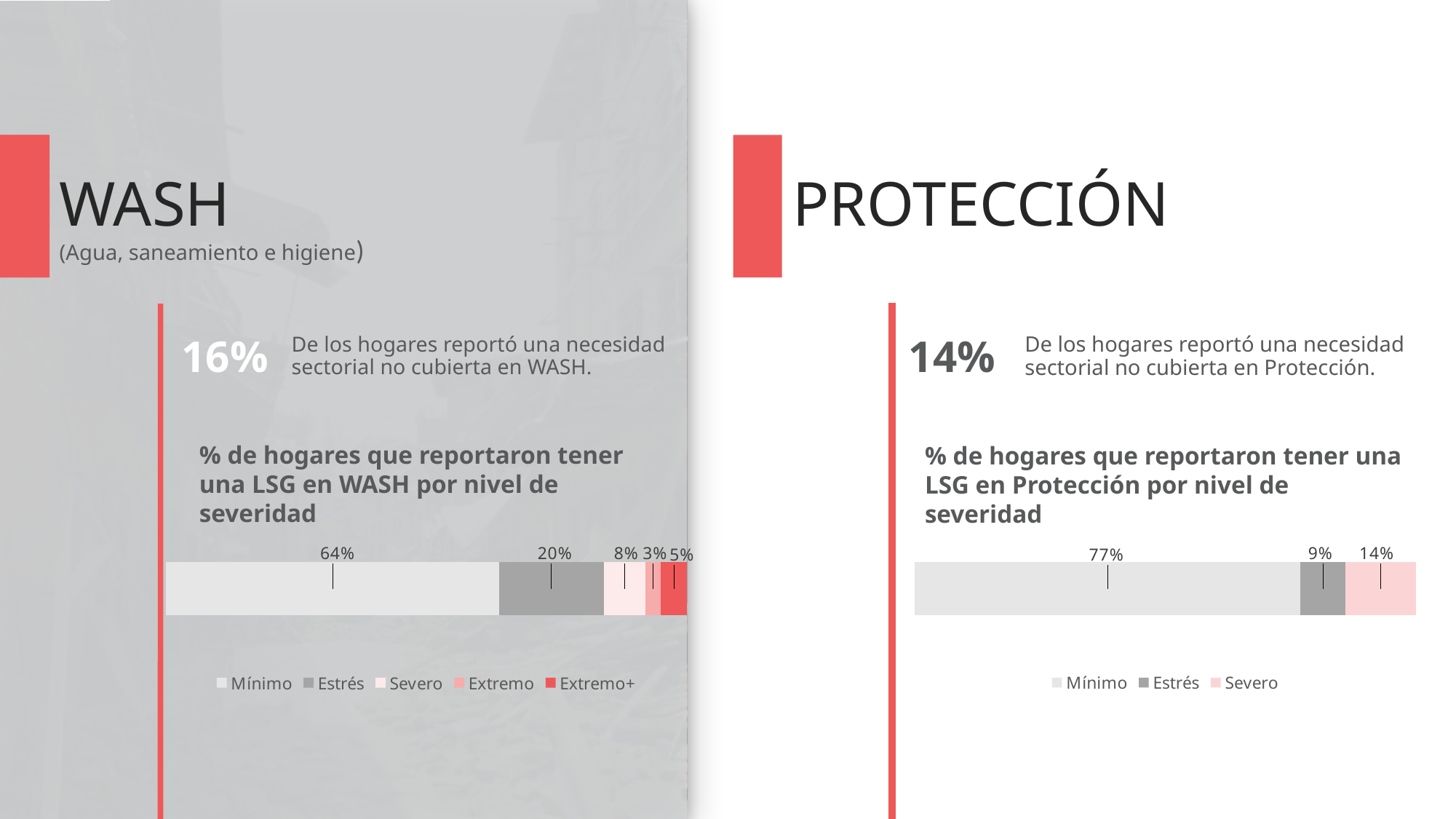
In the WASH chart, what is the difference between the Estrés and Severo percentages? 12% How many series does the legend of the Protección chart list? 3 In the WASH chart, what percentage of households is in the Estrés severity level? 20% In the WASH chart, what percentage of households is in the Mínimo severity level? 64% What kind of chart is used on the Protección side of the slide? Stacked bar chart In the Protección chart, what percentage of households is in the Severo severity level? 14% In the Protección chart, what percentage of households is in the Mínimo severity level? 77% In the Protección chart, which is larger, the Estrés share or the Severo share? Severo In the WASH chart, which severity level has the smallest share of households? Extremo How many series does the legend of the WASH chart list? 5 In the WASH chart, what percentage of households is in the Extremo+ severity level? 5% In the Protección chart, which severity level has the largest share of households? Mínimo